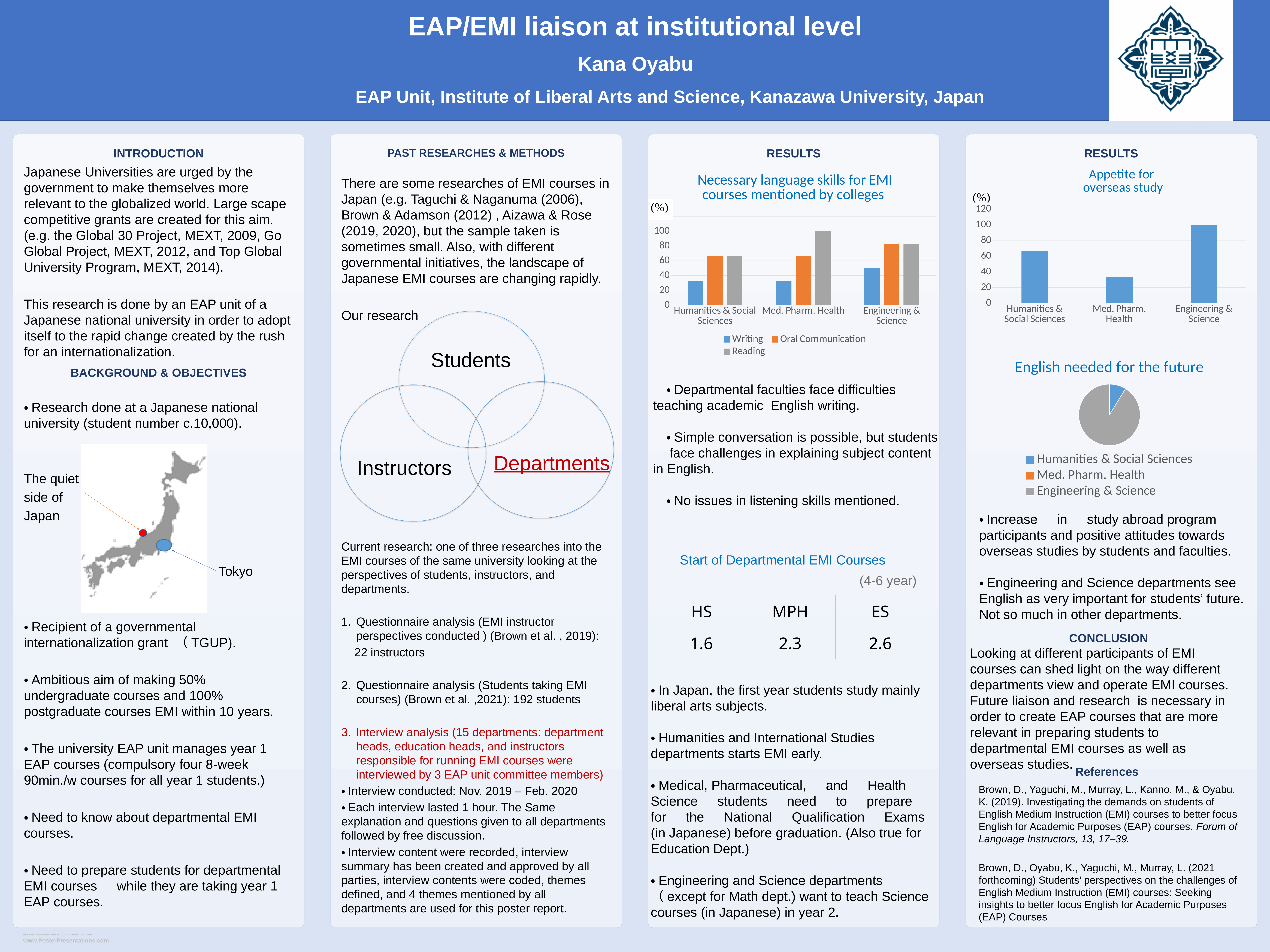
In the 'Necessary language skills for EMI courses mentioned by colleges' chart, is the Writing value for Humanities & Social Sciences greater or less than 40? less In the 'Necessary language skills for EMI courses mentioned by colleges' chart, which college has the highest Writing value? Engineering & Science How many college categories are shown on the x axis of the 'Necessary language skills for EMI courses mentioned by colleges' chart? 3 How many series does the legend of the 'Necessary language skills for EMI courses mentioned by colleges' chart list? 3 In the 'Appetite for overseas study' chart, which category has the lowest value? Med. Pharm. Health What kind of chart is the 'Necessary language skills for EMI courses mentioned by colleges' chart? bar chart In the 'Necessary language skills for EMI courses mentioned by colleges' chart, which is larger for Engineering & Science: Writing or Oral Communication? Oral Communication What kind of chart is the 'Appetite for overseas study' chart? bar chart In the 'Appetite for overseas study' chart, is the value for Humanities & Social Sciences greater or less than 40? greater In the 'Necessary language skills for EMI courses mentioned by colleges' chart, is the Reading value for Med. Pharm. Health greater or less than 80? greater In the 'Appetite for overseas study' chart, which category has the highest value? Engineering & Science In the 'English needed for the future' pie chart, which category has the largest slice? Engineering & Science